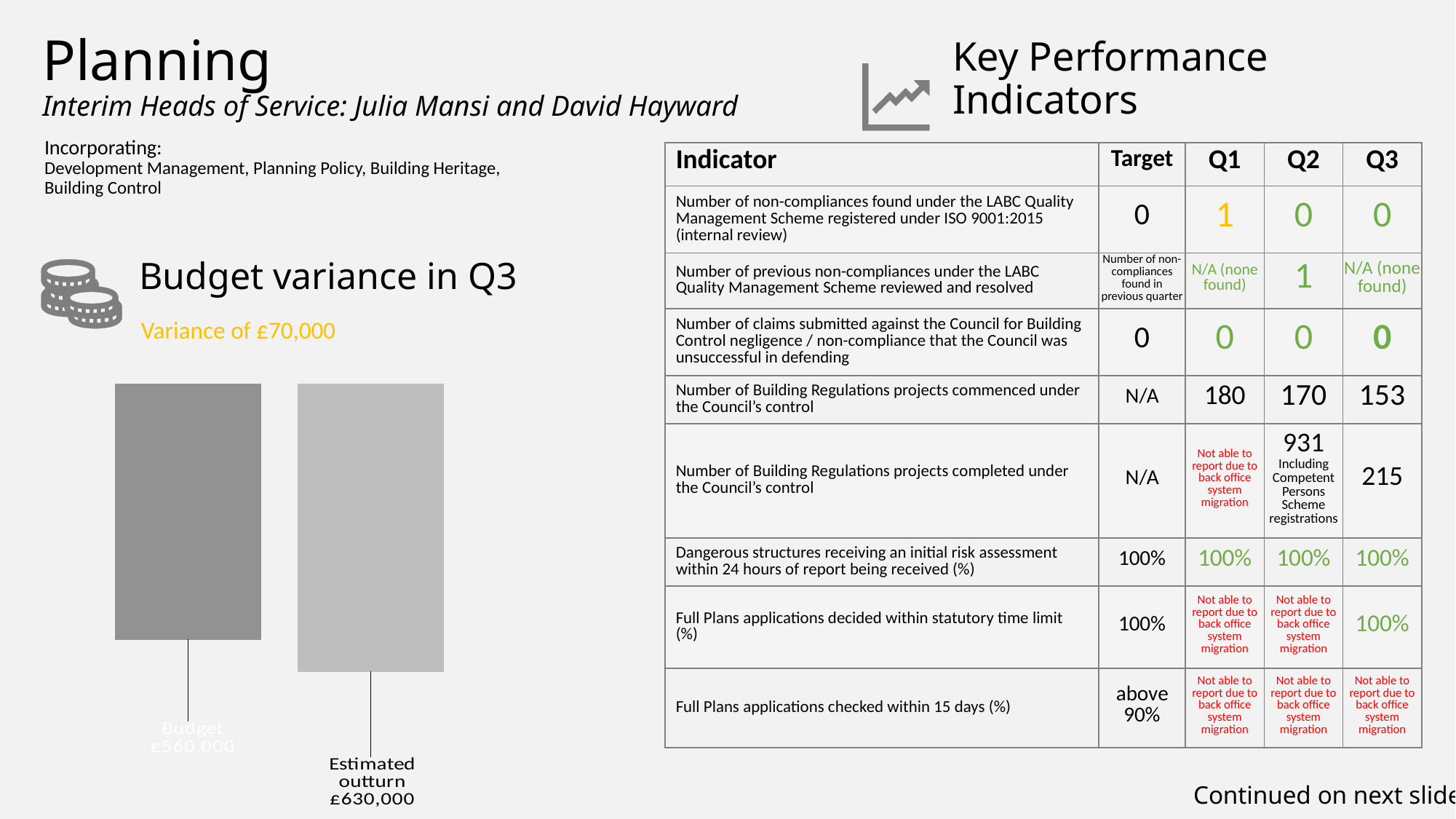
What is the title of the chart on the left of the slide? Budget variance in Q3 What type of chart is used to show the Budget variance in Q3? bar chart What variance amount is stated beneath the Budget variance in Q3 chart title? Variance of £70,000 What is the value of the Budget bar in the Budget variance in Q3 chart? £560,000 What is the difference between the Estimated outturn and the Budget in the Budget variance in Q3 chart? £70,000 Which bar in the Budget variance in Q3 chart has the higher value? Estimated outturn What is the value of the Estimated outturn bar in the Budget variance in Q3 chart? £630,000 In the Budget variance in Q3 chart, is the Estimated outturn larger or smaller than the Budget? larger Which bar in the Budget variance in Q3 chart has the lower value? Budget How many bars are shown in the Budget variance in Q3 chart? 2